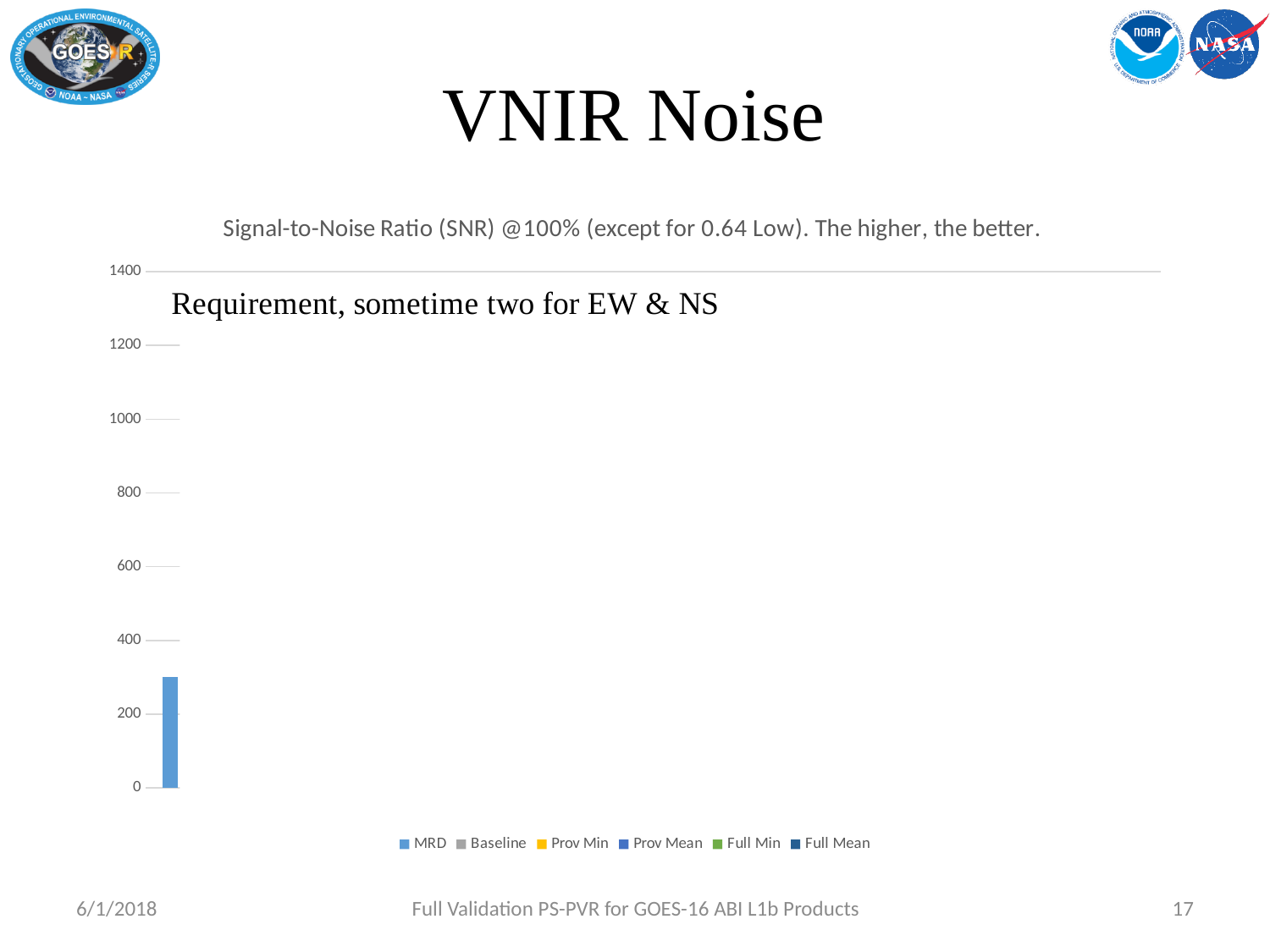
How many series does the chart legend list? 6 What is the highest value shown on the chart's vertical axis? 1400 What is the title of the chart? Signal-to-Noise Ratio (SNR) @100% (except for 0.64 Low). The higher, the better. Is the value of the visible MRD bar greater or less than 400? less Is the value of the visible MRD bar greater or less than 200? greater Which series is listed first in the chart legend? MRD What kind of chart is shown on the slide? bar chart